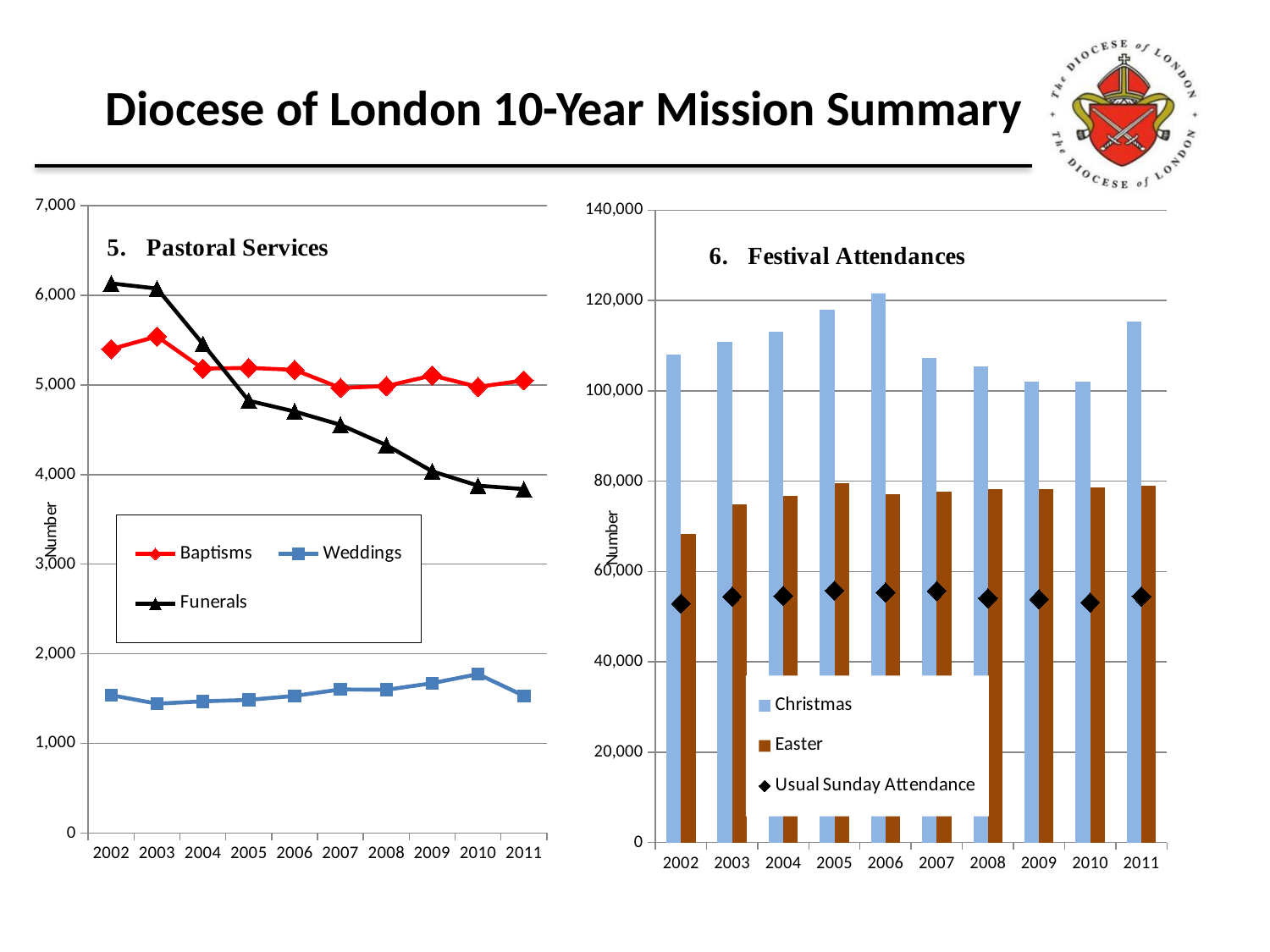
On the Festival Attendances chart, in which year is the Christmas attendance highest? 2006 On the Pastoral Services chart, which series has the lowest value in 2011? Weddings On the Festival Attendances chart, in which year is the Easter attendance lowest? 2002 On the Festival Attendances chart, which is larger in 2011, Christmas or Easter? Christmas On the Festival Attendances chart, is the Easter value for 2002 greater or less than 60,000? greater On the Pastoral Services chart, is the Funerals value for 2002 greater or less than 6,000? greater What kind of chart is the Pastoral Services chart? line chart On the Festival Attendances chart, how many years are shown on the x axis? 10 On the Pastoral Services chart, which is larger in 2002, Funerals or Baptisms? Funerals On the Pastoral Services chart, is the Weddings value for 2010 greater or less than 2,000? less On the Pastoral Services chart, how many series does the legend list? 3 On the Pastoral Services chart, do the Funerals values rise or fall from 2002 to 2011? fall